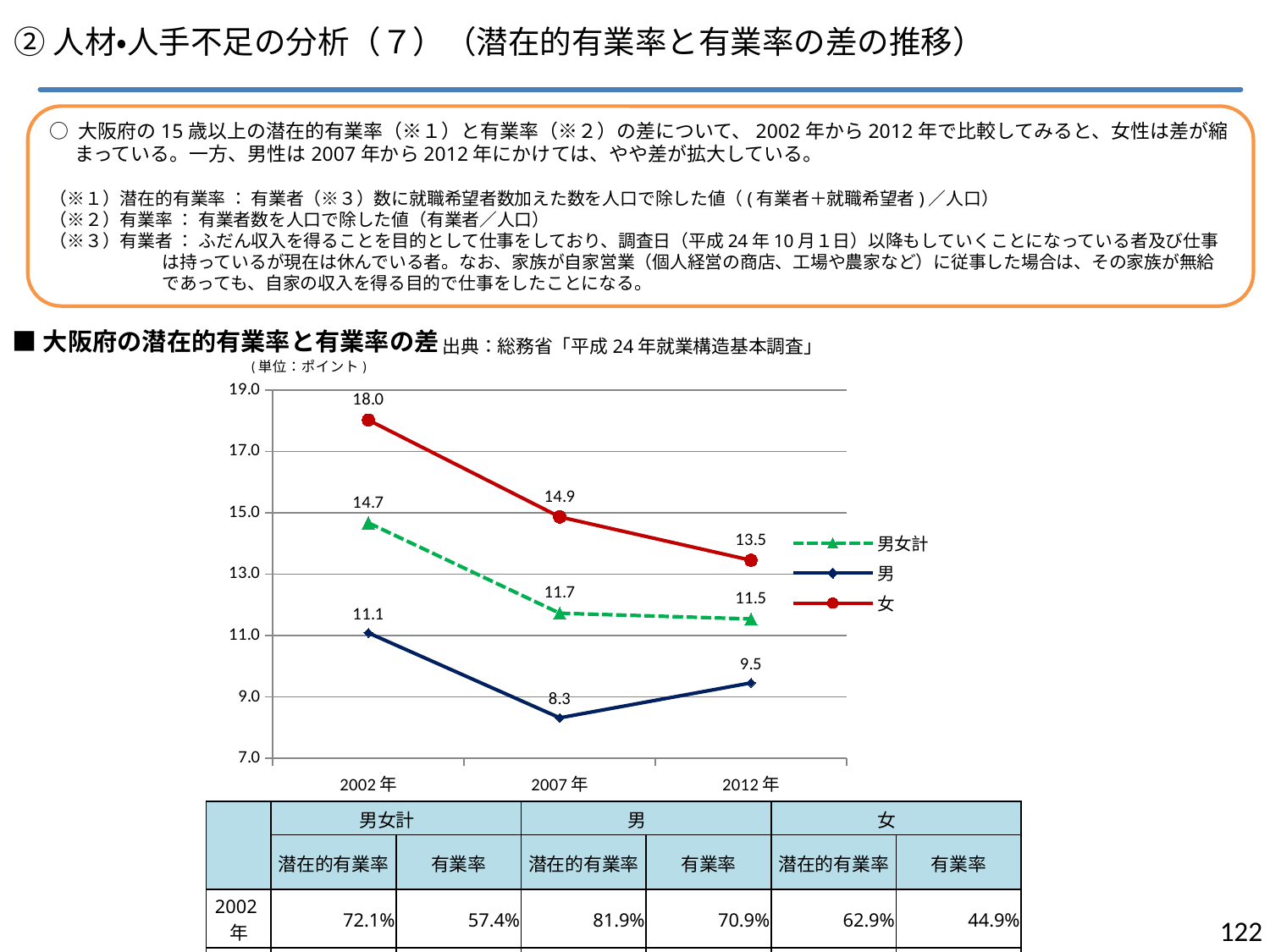
Which series has the highest value in 2012年? 女 How many years are plotted on the x axis? 3 What type of chart is shown on the slide? line chart Which is larger, the 男 value in 2002年 or the 男 value in 2012年? 2002年 What is the value for 女 in 2002年? 18.0 Which series is drawn with a dashed line? 男女計 Does the 男 series rise or fall from 2007年 to 2012年? rise What is the value for 男女計 in 2012年? 11.5 What is the difference between the 女 values in 2002年 and 2012年? 4.5 What is the value for 男 in 2007年? 8.3 Which series has the lowest value in 2007年? 男 How many series does the chart legend list? 3